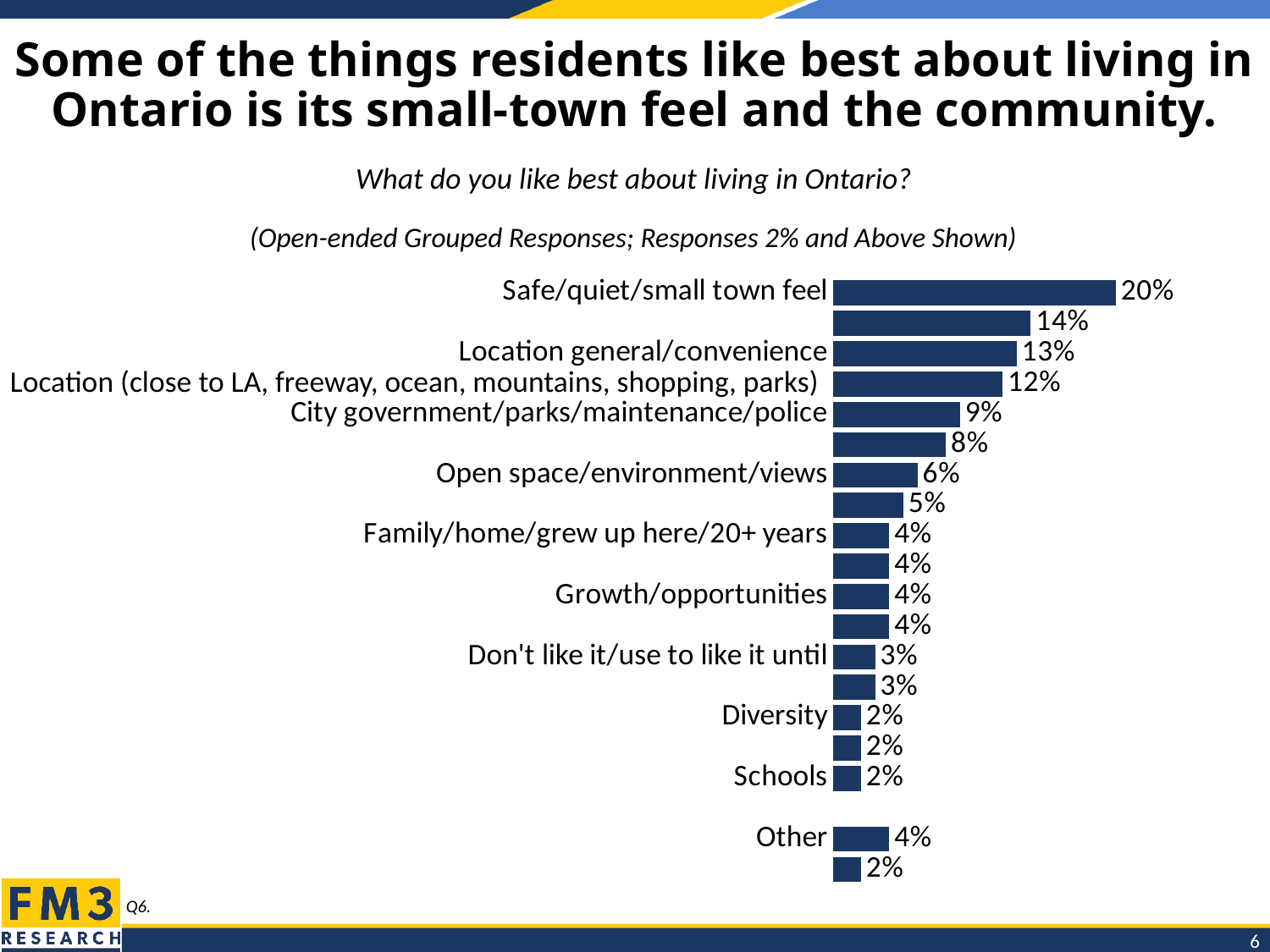
Which response category has the highest percentage? Safe/quiet/small town feel What survey question is the chart based on, as stated on the slide? What do you like best about living in Ontario? What kind of chart is shown on the slide? Bar chart What percentage is shown for City government/parks/maintenance/police? 9% What value is shown for Location general/convenience? 13% What is the difference between the percentage for Safe/quiet/small town feel and the percentage for Location general/convenience? 7% What percentage of respondents said Safe/quiet/small town feel is what they like best about living in Ontario? 20% Do the bar values generally increase or decrease going from the top of the chart to the bottom? Decrease What value is shown for Open space/environment/views? 6% What is the difference between the value for Location (close to LA, freeway, ocean, mountains, shopping, parks) and the value for City government/parks/maintenance/police? 3% Which has a larger value: Open space/environment/views or Growth/opportunities? Open space/environment/views What percentage is shown for the Other category? 4%